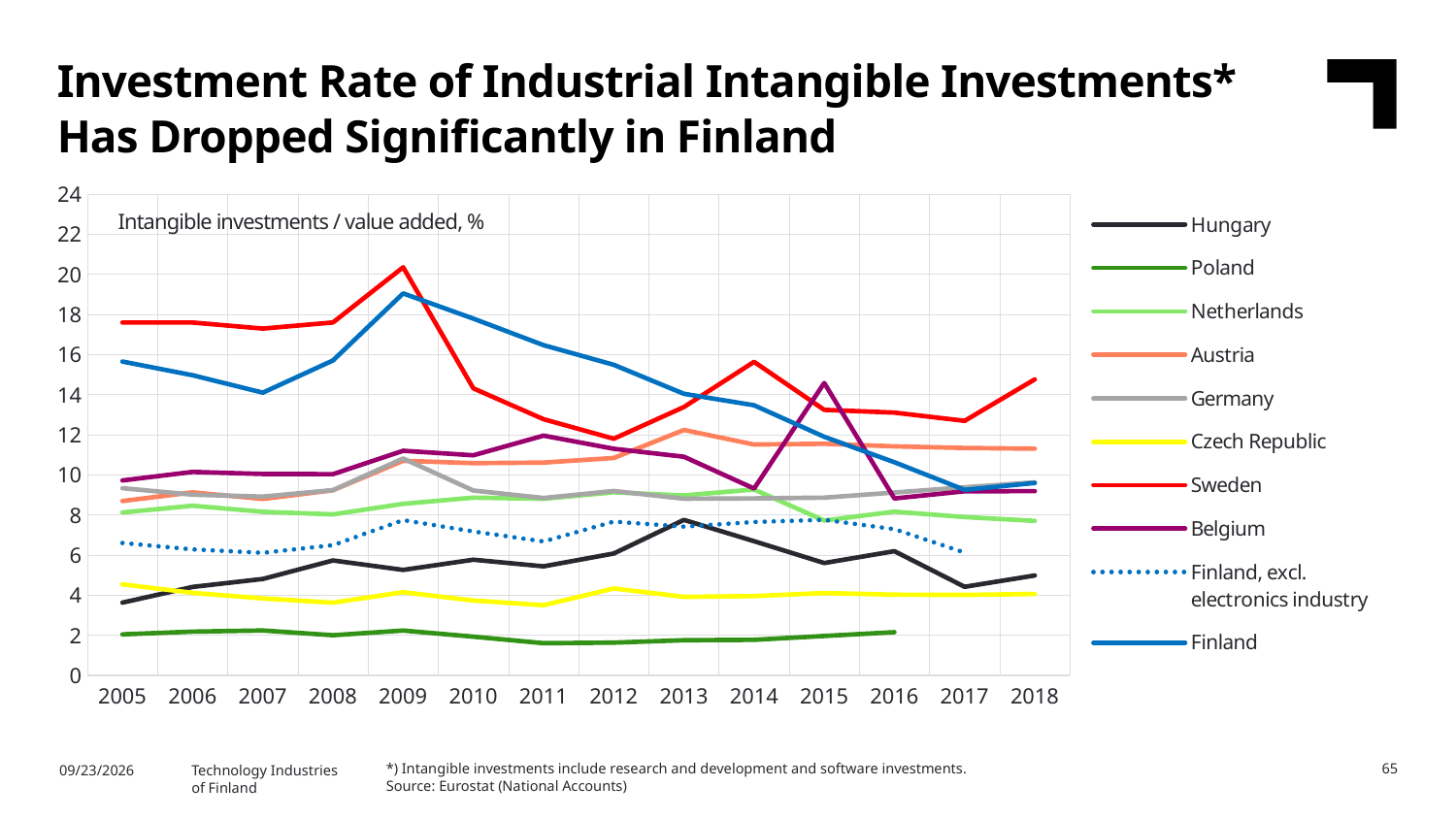
Which country has the lowest values across the whole period? Poland Is the value for Finland in 2018 greater or less than 12? less How many years are shown on the x axis? 14 What kind of chart is shown on the slide? line chart Which is larger in 2014, the value for Sweden or the value for Finland? Sweden Is the value for Belgium in 2015 greater or less than 12? greater Which series is drawn with a dotted line? Finland, excl. electronics industry Which country has the highest value in 2009? Sweden Does the Finland line rise or fall between 2009 and 2017? fall How many series does the legend list? 10 What is the title of the chart on the slide? Investment Rate of Industrial Intangible Investments* Has Dropped Significantly in Finland Is the value for Sweden in 2009 greater or less than 18? greater